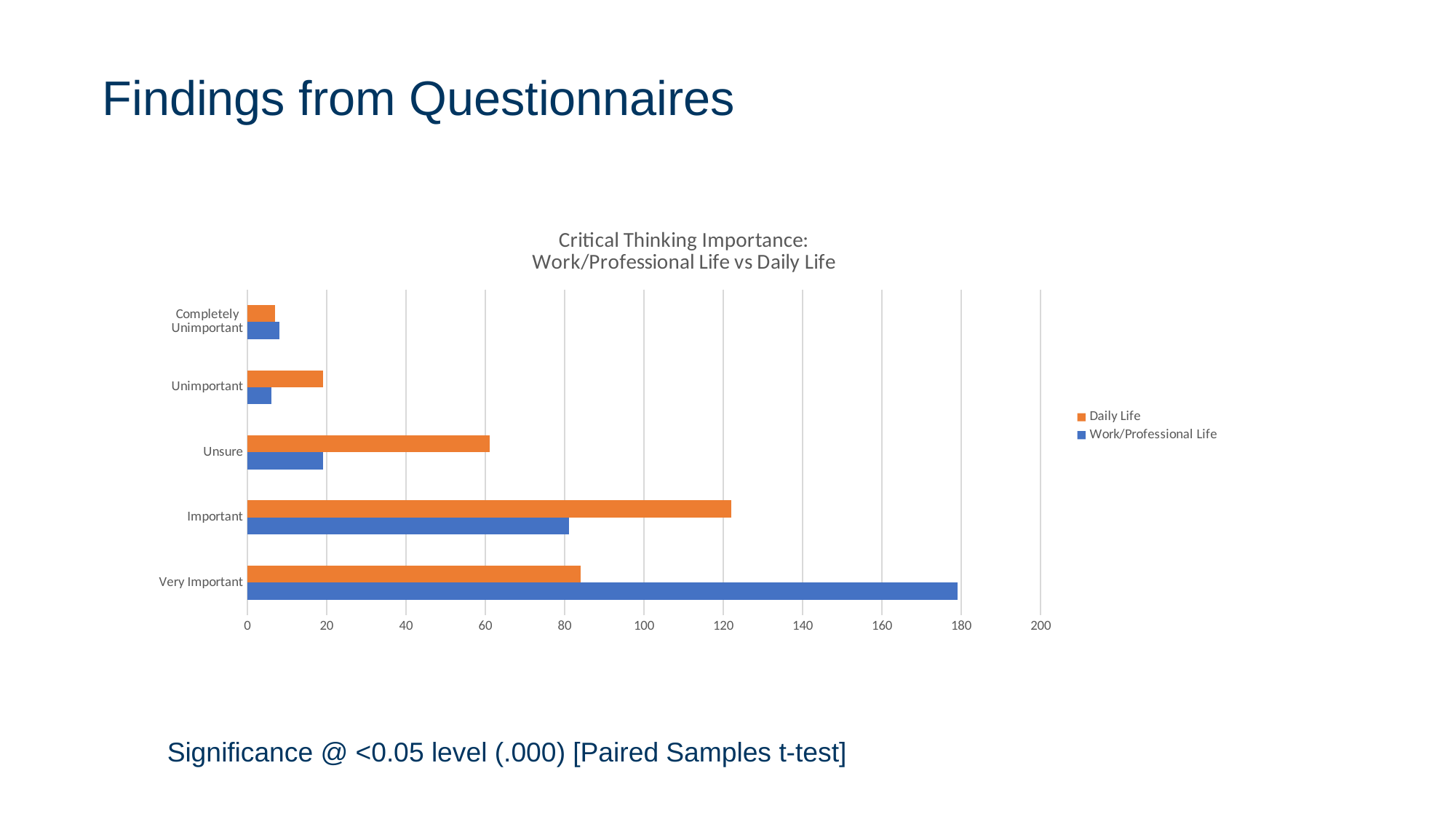
Is the Work/Professional Life value for Unsure greater or less than 40? less Is the Daily Life value for Important greater or less than 100? greater For Important, which series has the larger value, Daily Life or Work/Professional Life? Daily Life What kind of chart is shown on the slide? bar chart Which category has the lowest value for Daily Life? Completely Unimportant Which category has the highest value for Daily Life? Important How many categories are shown on the vertical axis? 5 Which series is shown in orange in the legend? Daily Life For Very Important, which series has the larger value, Daily Life or Work/Professional Life? Work/Professional Life Is the Work/Professional Life value for Very Important greater or less than 160? greater Which category has the highest value for Work/Professional Life? Very Important How many series does the legend list? 2